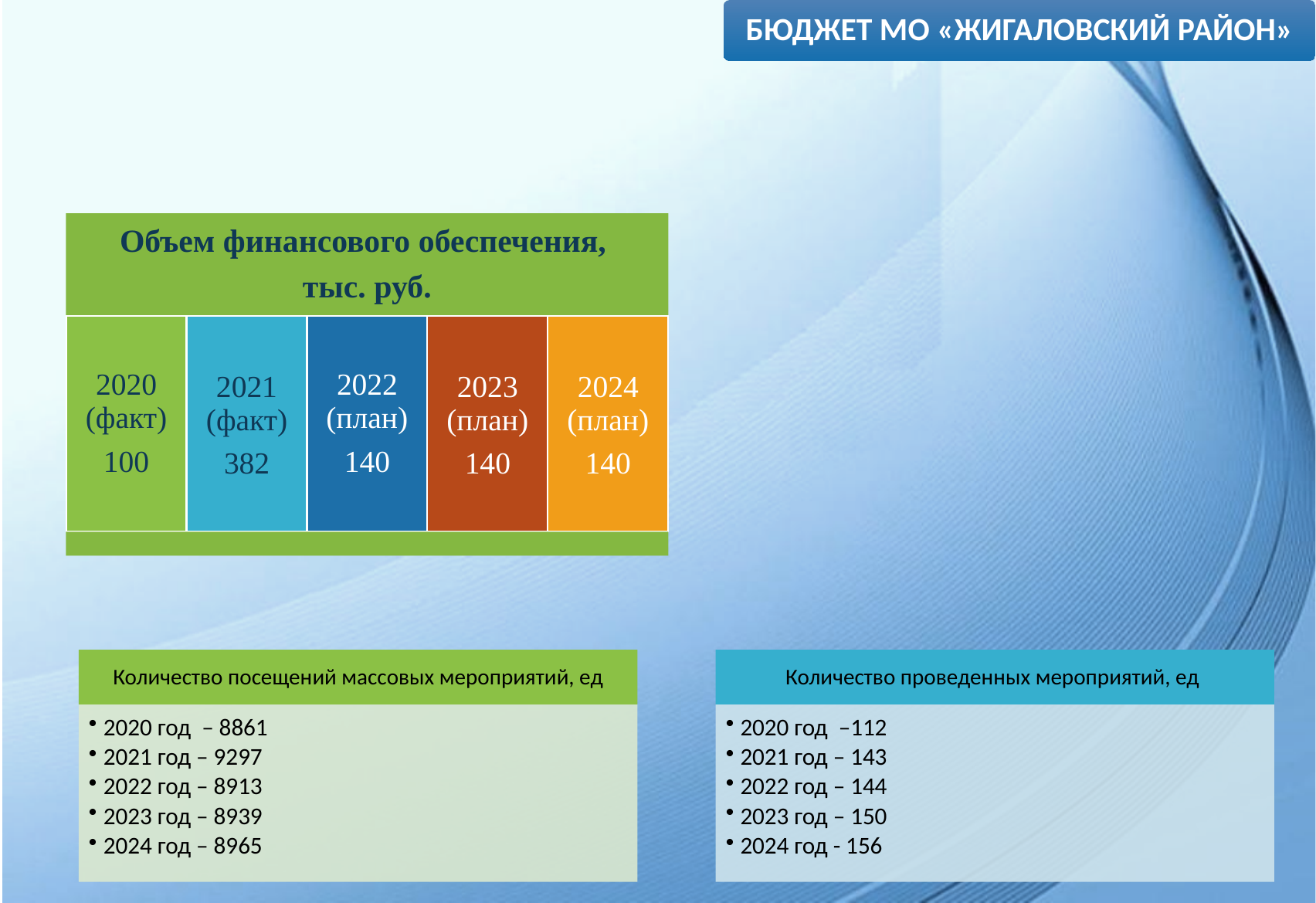
What is the title of the colored block graphic on the left of the slide? Объем финансового обеспечения, тыс. руб. In the 'Объем финансового обеспечения, тыс. руб.' graphic, what is the value for 2020 (факт)? 100 In the 'Объем финансового обеспечения, тыс. руб.' graphic, what colour is the block for 2024 (план)? Orange In the 'Объем финансового обеспечения, тыс. руб.' graphic, what is the difference between the 2021 value and the 2022 planned value? 242 In the 'Объем финансового обеспечения, тыс. руб.' graphic, which year has the lowest value? 2020 (факт) In the 'Объем финансового обеспечения, тыс. руб.' graphic, which year has the highest value? 2021 (факт) In the 'Объем финансового обеспечения, тыс. руб.' graphic, how many years are marked as 'план'? 3 In the 'Объем финансового обеспечения, тыс. руб.' graphic, what is the difference between the 2021 value and the 2020 value? 282 How many years are shown in the 'Объем финансового обеспечения, тыс. руб.' graphic? 5 In the 'Объем финансового обеспечения, тыс. руб.' graphic, what is the value for 2021 (факт)? 382 In the 'Объем финансового обеспечения, тыс. руб.' graphic, what is the planned value for 2023? 140 In the 'Объем финансового обеспечения, тыс. руб.' graphic, which is larger: the value for 2020 or the value for 2022? 2022